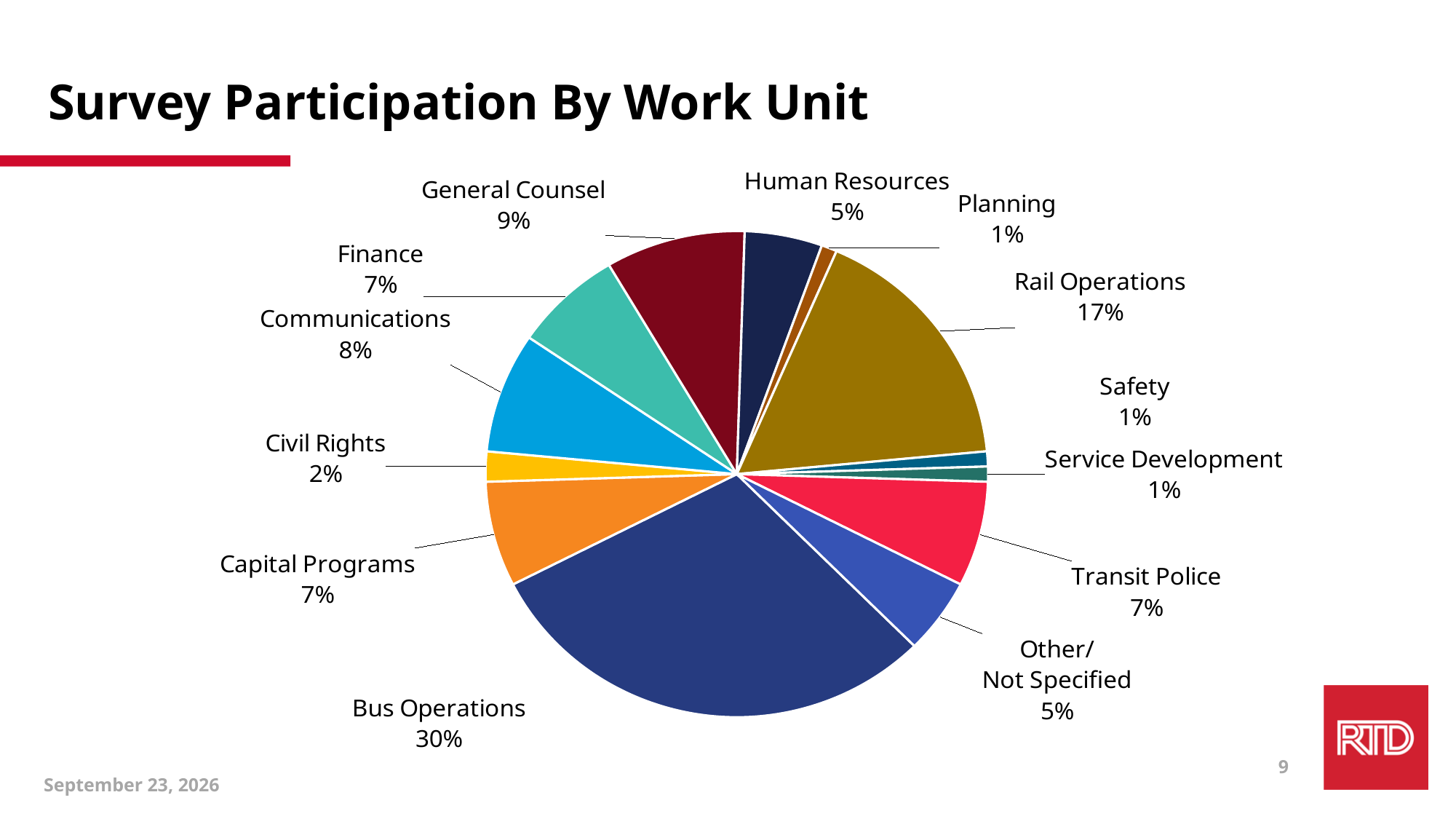
What is the title of the chart? Survey Participation By Work Unit What share of survey participation is Other/Not Specified? 5% What share of survey participation is Civil Rights? 2% How many work units are shown in the pie chart? 13 What is the difference in percentage points between Bus Operations and Rail Operations? 13 What is the difference in percentage points between General Counsel and Human Resources? 4 Which has a larger share, Communications or Finance? Communications What share of survey participation is Bus Operations? 30% What share of survey participation is General Counsel? 9% What share of survey participation is Rail Operations? 17% What kind of chart is shown on the slide? pie chart Which work unit has the largest share of survey participation? Bus Operations